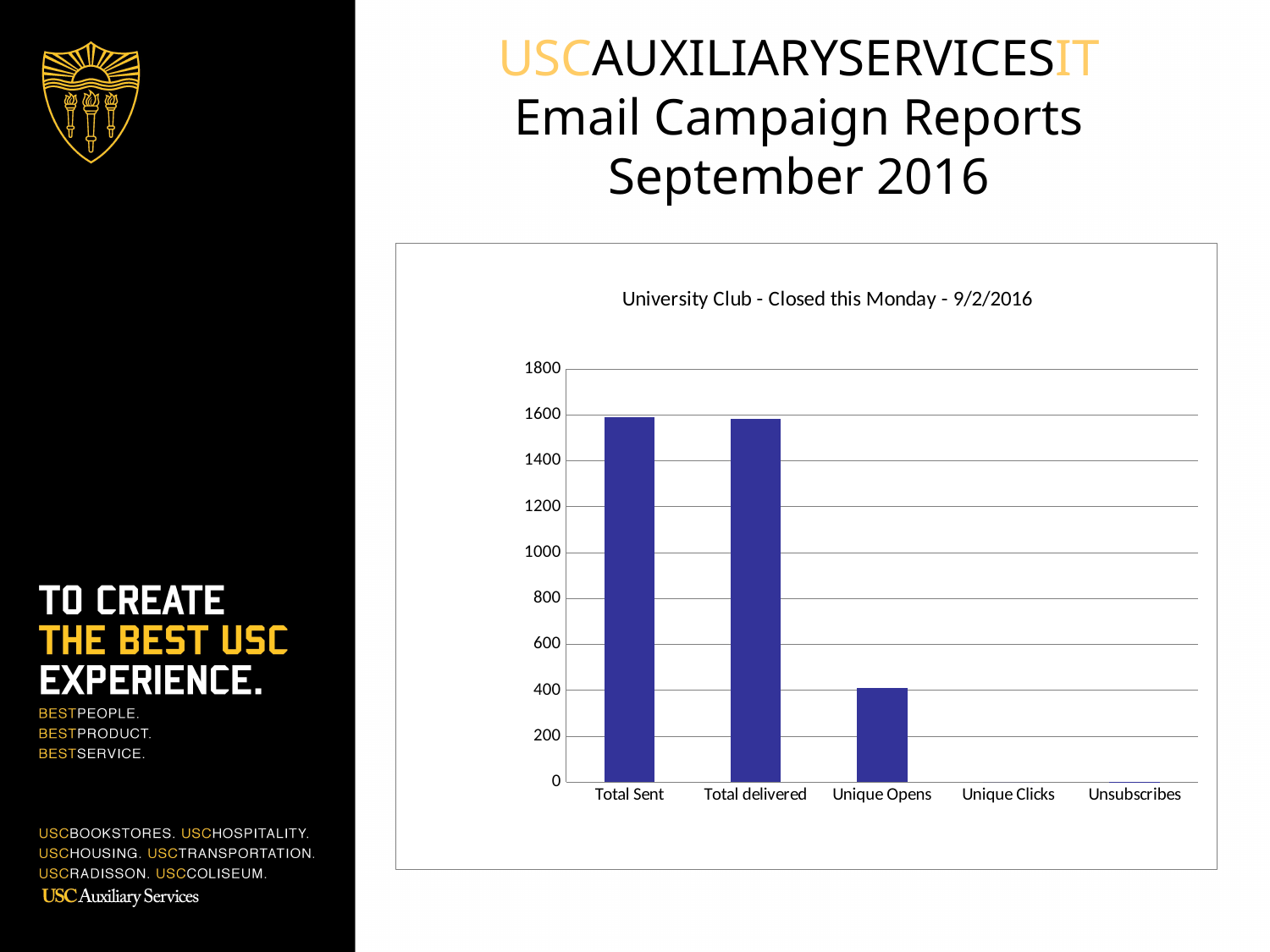
Which is larger, the value for Total Sent or the value for Unique Opens? Total Sent Is the value for Unique Opens greater or less than 200? greater What is the title of the chart? University Club - Closed this Monday - 9/2/2016 What kind of chart is shown on the slide? bar chart Is the value for Total Sent greater or less than 1400? greater Which is larger, the value for Unique Opens or the value for Unsubscribes? Unique Opens Is the value for Unique Opens greater or less than 600? less How many categories are shown on the x axis of the chart? 5 Do the values generally rise or fall moving from left to right along the x axis? fall What is the highest value shown on the vertical axis of the chart? 1800